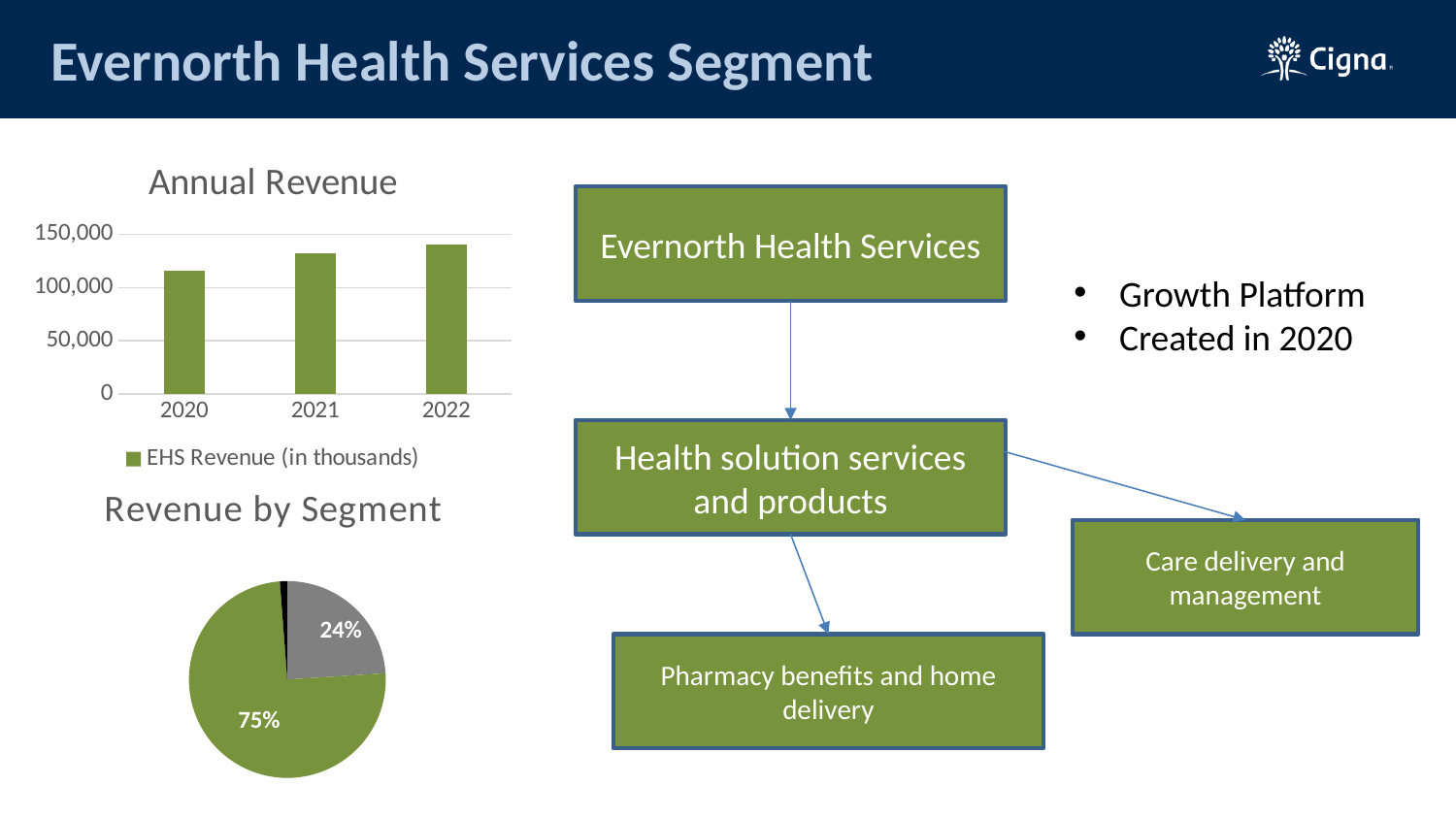
How many series does the legend of the Annual Revenue chart list? 1 In the Annual Revenue chart, is the value for 2022 greater or less than 150,000? less In the Annual Revenue chart, which year has the lowest revenue? 2020 What is the legend entry of the Annual Revenue chart? EHS Revenue (in thousands) In the Revenue by Segment chart, what is the difference between the 75% slice and the 24% slice? 51 percentage points In the Annual Revenue chart, which year has the highest revenue? 2022 How many years are shown on the x axis of the Annual Revenue chart? 3 In the Revenue by Segment chart, what share does the largest slice have? 75% What type of chart is the Revenue by Segment chart? pie chart In the Annual Revenue chart, do the values rise or fall from 2020 to 2022? rise In the Annual Revenue chart, is the value for 2020 greater or less than 100,000? greater What type of chart is the Annual Revenue chart? bar chart